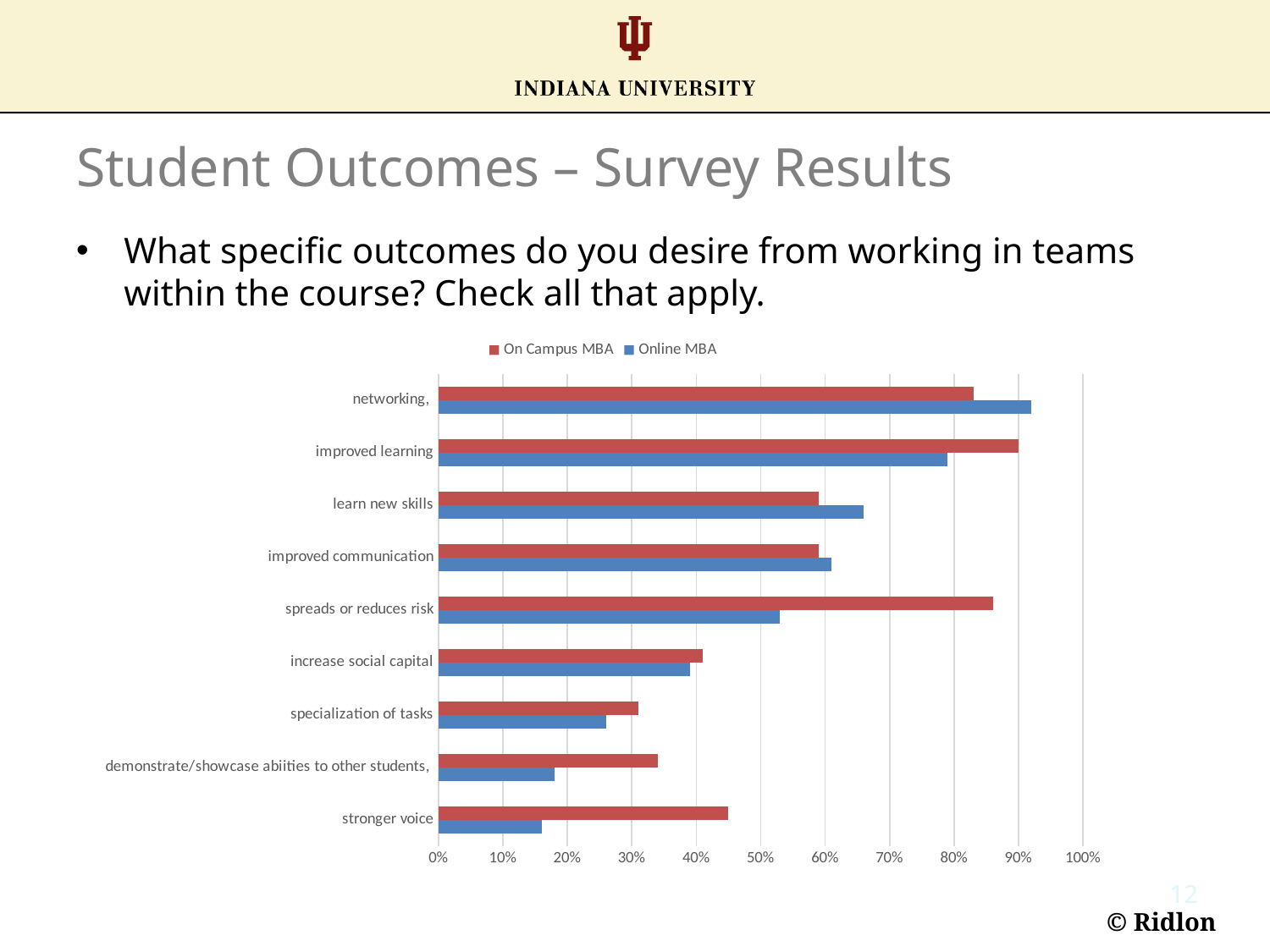
Which series is shown in red in the chart legend? On Campus MBA Is the Online MBA value for 'specialization of tasks' greater or less than 30%? less What kind of chart is shown on the slide? bar chart For 'networking,', which series has the larger value, On Campus MBA or Online MBA? Online MBA Is the Online MBA value for 'networking,' greater or less than 90%? greater How many outcome categories are plotted on the chart? 9 For 'spreads or reduces risk', which series has the larger value, On Campus MBA or Online MBA? On Campus MBA Is the Online MBA value for 'stronger voice' greater or less than 20%? less For 'stronger voice', which series has the larger value, On Campus MBA or Online MBA? On Campus MBA How many series does the chart legend list? 2 For the Online MBA series, which outcome has the highest value? networking,